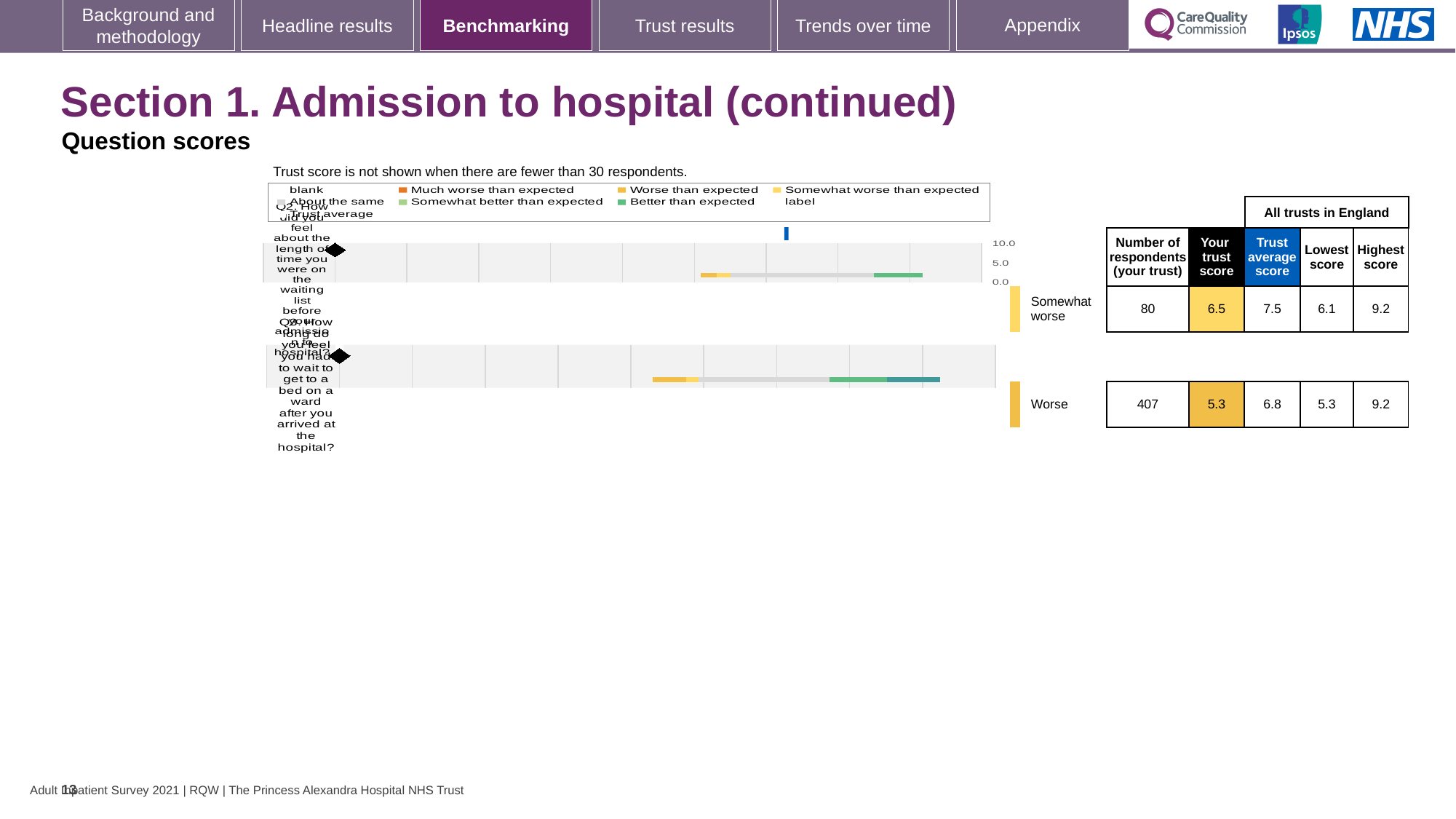
Is this trust's score for Q3 greater or less than 5.0 on the chart axis? greater How many respondents answered Q3 at this trust? 407 What benchmark category label is shown next to the Q3 bar? Worse How many questions are plotted on the chart? 2 What is the difference between the trust average score and this trust's score for Q3? 1.5 What is the trust average score across all trusts in England for Q2? 7.5 What is the highest score across all trusts in England for Q3? 9.2 Which question has the higher trust score for this trust, Q2 or Q3? Q2 How many respondents answered Q2 at this trust? 80 What is the difference between the highest score and the lowest score for Q2 across all trusts in England? 3.1 What is the trust score for Q3 (how long did you feel you had to wait to get to a bed on a ward after you arrived at the hospital)? 5.3 What is the trust score for Q2 (how did you feel about the length of time you were on the waiting list before admission)? 6.5